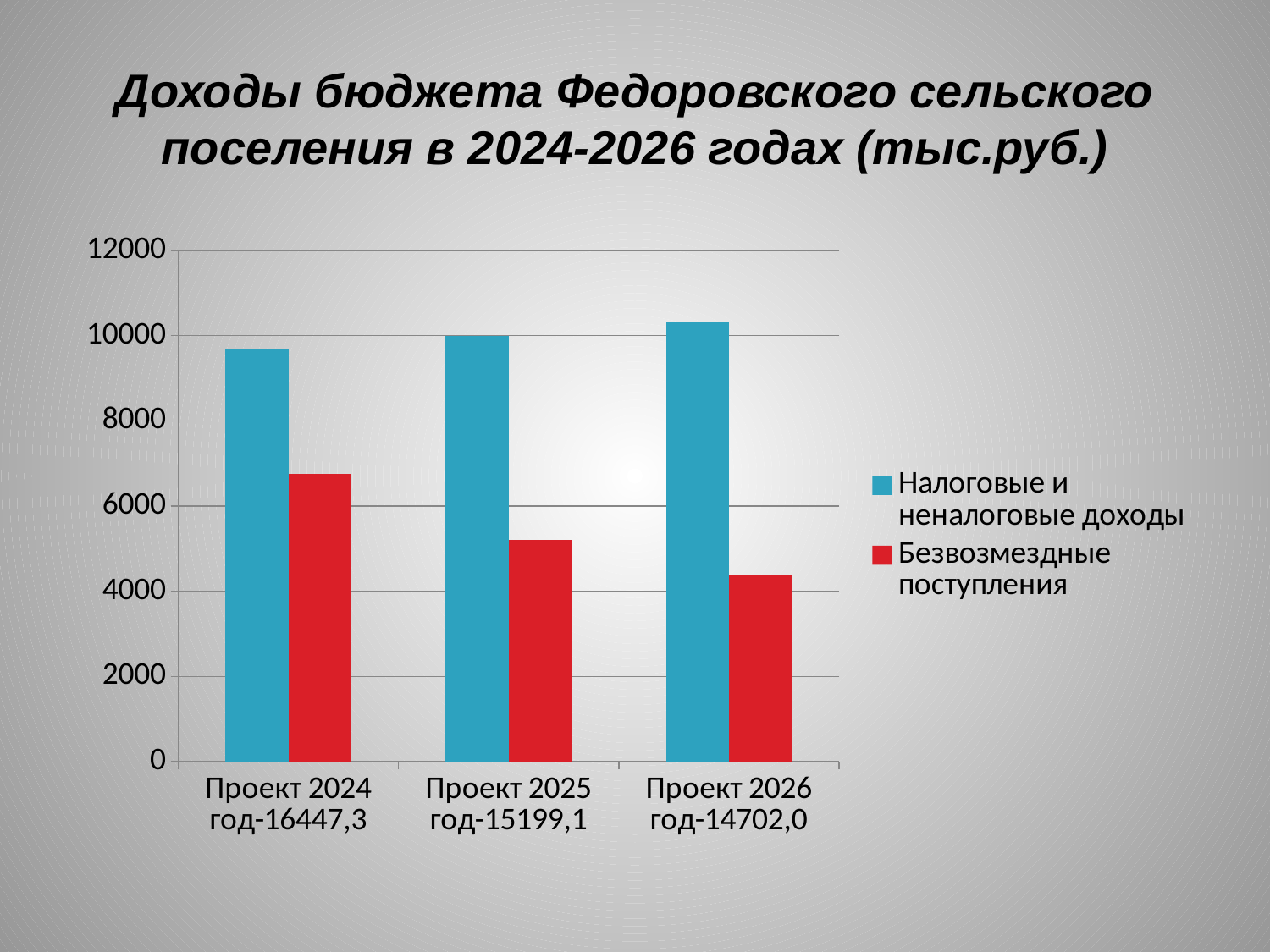
What total is printed in the x-axis label for Проект 2026 год? 14702,0 In which category is the value for Безвозмездные поступления lowest? Проект 2026 год-14702,0 For Проект 2024 год, which series has the larger value: Налоговые и неналоговые доходы or Безвозмездные поступления? Налоговые и неналоговые доходы How many categories are shown on the x axis? 3 Do the values for Безвозмездные поступления rise or fall from Проект 2024 to Проект 2026? fall What total is printed in the x-axis label for Проект 2024 год? 16447,3 Is the value for Безвозмездные поступления in Проект 2026 год greater or less than 6000? less In which category is the value for Безвозмездные поступления highest? Проект 2024 год-16447,3 What colour represents Налоговые и неналоговые доходы in the legend? blue How many series does the legend list? 2 What type of chart is shown on the slide? bar chart Is the value for Безвозмездные поступления in Проект 2024 год greater or less than 6000? greater